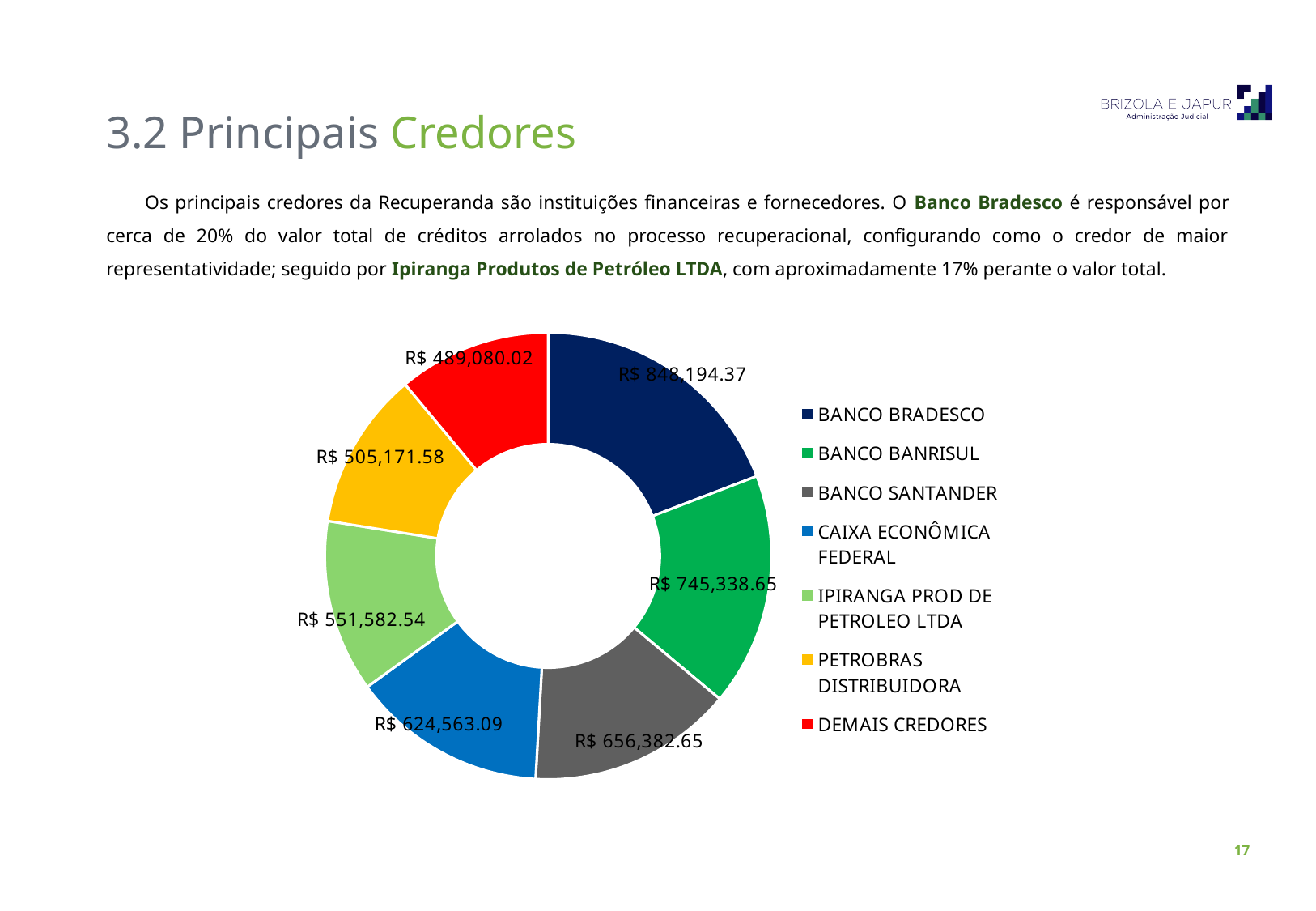
Which category has the smallest value in the chart? DEMAIS CREDORES What is the value shown for PETROBRAS DISTRIBUIDORA? R$ 505,171.58 What kind of chart is shown on the slide? doughnut chart Which creditor has the largest value in the chart? BANCO BRADESCO How many categories does the chart show? 7 What is the difference between the values for BANCO BRADESCO and BANCO BANRISUL? R$ 102,855.72 What is the difference between the values for BANCO SANTANDER and CAIXA ECONÔMICA FEDERAL? R$ 31,819.56 What is the value shown for IPIRANGA PROD DE PETROLEO LTDA? R$ 551,582.54 What is the value shown for CAIXA ECONÔMICA FEDERAL? R$ 624,563.09 Which is larger, the value for BANCO BANRISUL or the value for BANCO SANTANDER? BANCO BANRISUL What is the value shown for BANCO BRADESCO? R$ 848,194.37 What colour is the slice for DEMAIS CREDORES? red